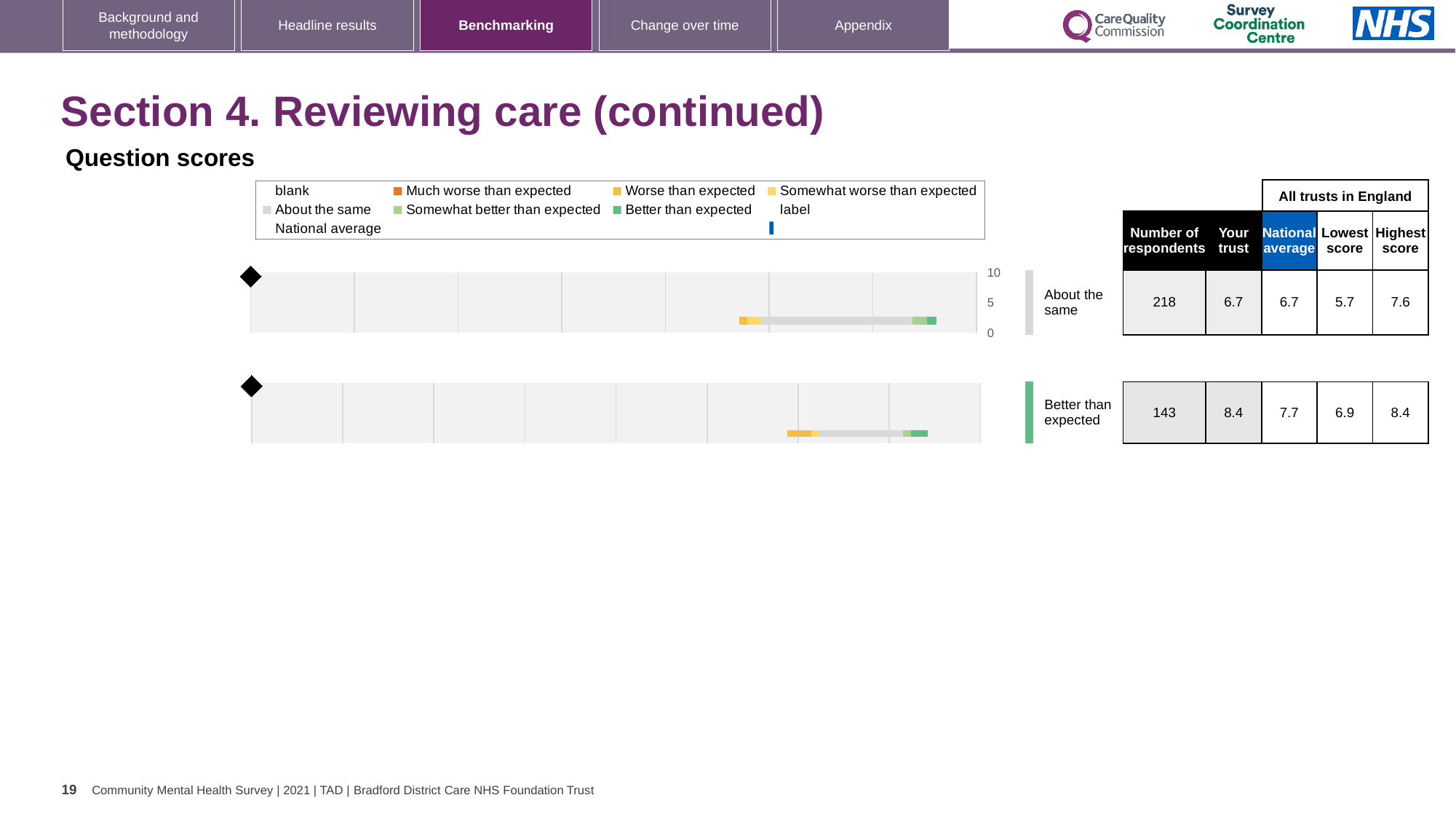
What is the number of respondents for the row labelled 'About the same'? 218 Which row has the larger 'Your trust' score, 'About the same' or 'Better than expected'? Better than expected What is the lowest score among all trusts in England for the row labelled 'Better than expected'? 6.9 What is the highest score among all trusts in England for the row labelled 'About the same'? 7.6 What is the national average for the row labelled 'Better than expected'? 7.7 For the row labelled 'About the same', what is the 'Your trust' score shown in the table? 6.7 Which row has more respondents, 'About the same' or 'Better than expected'? About the same For the row labelled 'Better than expected', what is the difference between the 'Your trust' score and the national average? 0.7 What is the number of respondents for the row labelled 'Better than expected'? 143 What kind of chart is used to show the benchmarking bands on this slide? Bar chart For the row labelled 'Better than expected', what is the 'Your trust' score shown in the table? 8.4 What is the maximum value shown on the vertical axis of the top chart? 10